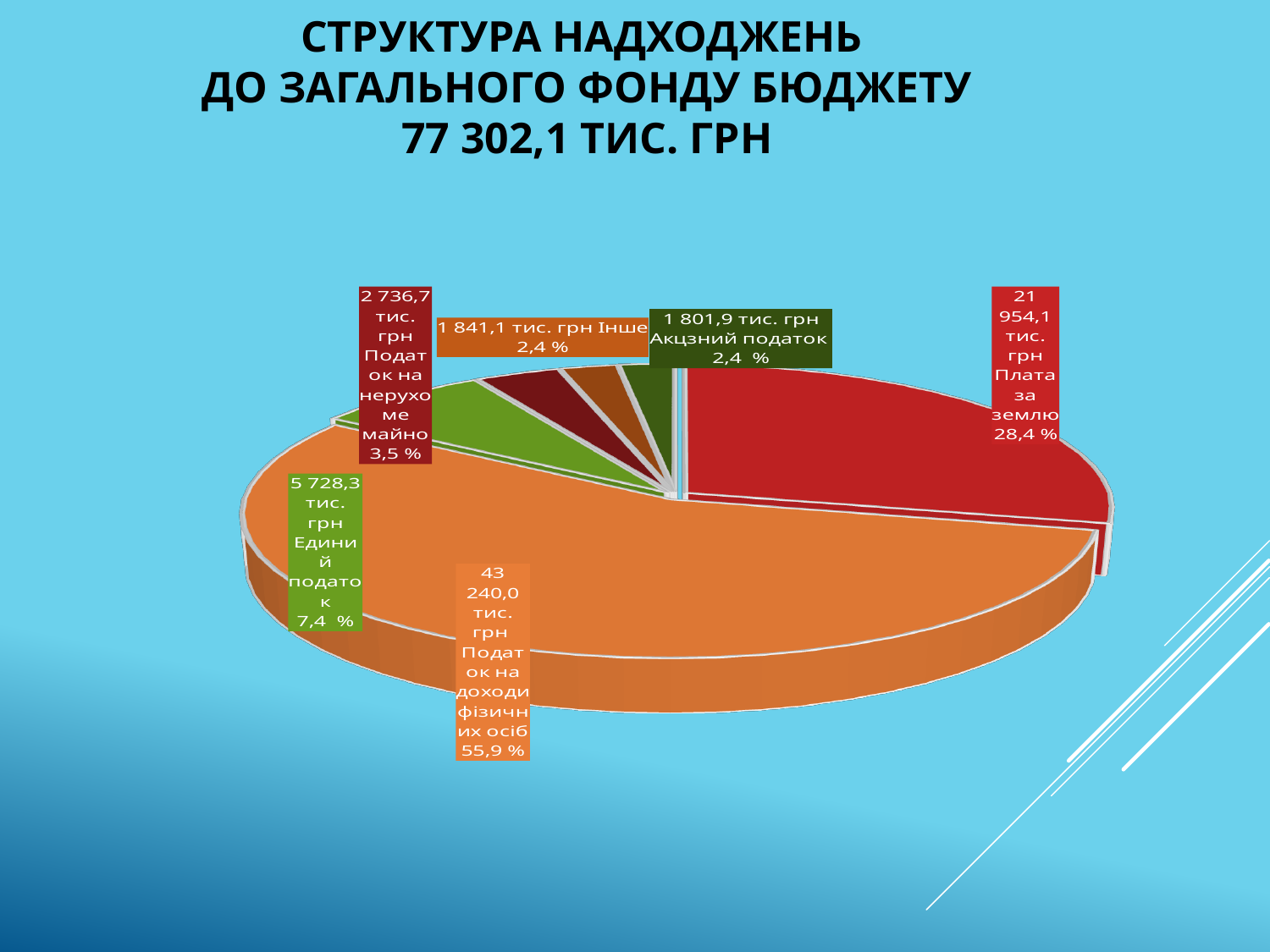
What share of the pie does Акцизний податок represent? 2,4 % What kind of chart is shown on the slide? pie chart What is the value for Единий податок? 5 728,3 тис. грн What is the value for Податок на доходи фізичних осіб? 43 240,0 тис. грн What is the value for Плата за землю? 21 954,1 тис. грн Which is larger, the value for Інше or the value for Акцизний податок? Інше What is the value for Податок на нерухоме майно? 2 736,7 тис. грн Which category has the largest slice? Податок на доходи фізичних осіб What is the difference between the values for Податок на доходи фізичних осіб and Плата за землю? 21 285,9 тис. грн Which category has the smallest value? Акцизний податок What share of the pie does Плата за землю represent? 28,4 % What total amount is stated in the chart title? 77 302,1 тис. грн